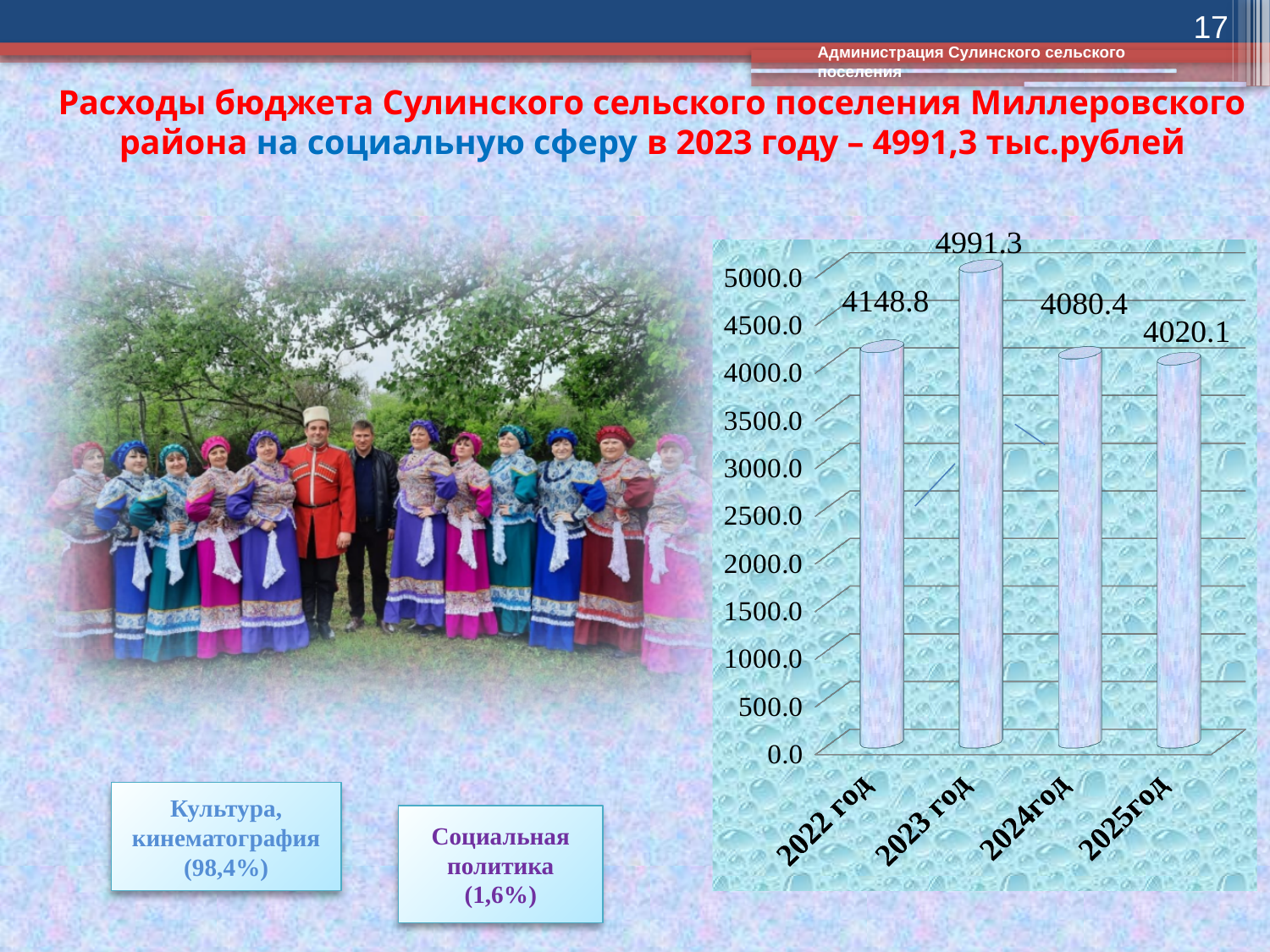
Which is larger, the value for 2022 год or the value for 2024год? 2022 год Is the value for 2023 год greater or less than 4500.0? greater What is the difference between the values for 2023 год and 2022 год? 842.5 What is the value shown for 2022 год? 4148.8 What is the difference between the values for 2024год and 2025год? 60.3 What is the value shown for 2023 год? 4991.3 From 2023 год to 2025год, do the values rise or fall? fall How many years are shown on the x axis of the chart? 4 Which year has the highest value in the chart? 2023 год What kind of chart is shown on the slide? bar chart What is the value shown for 2025год? 4020.1 Which year has the lowest value in the chart? 2025год